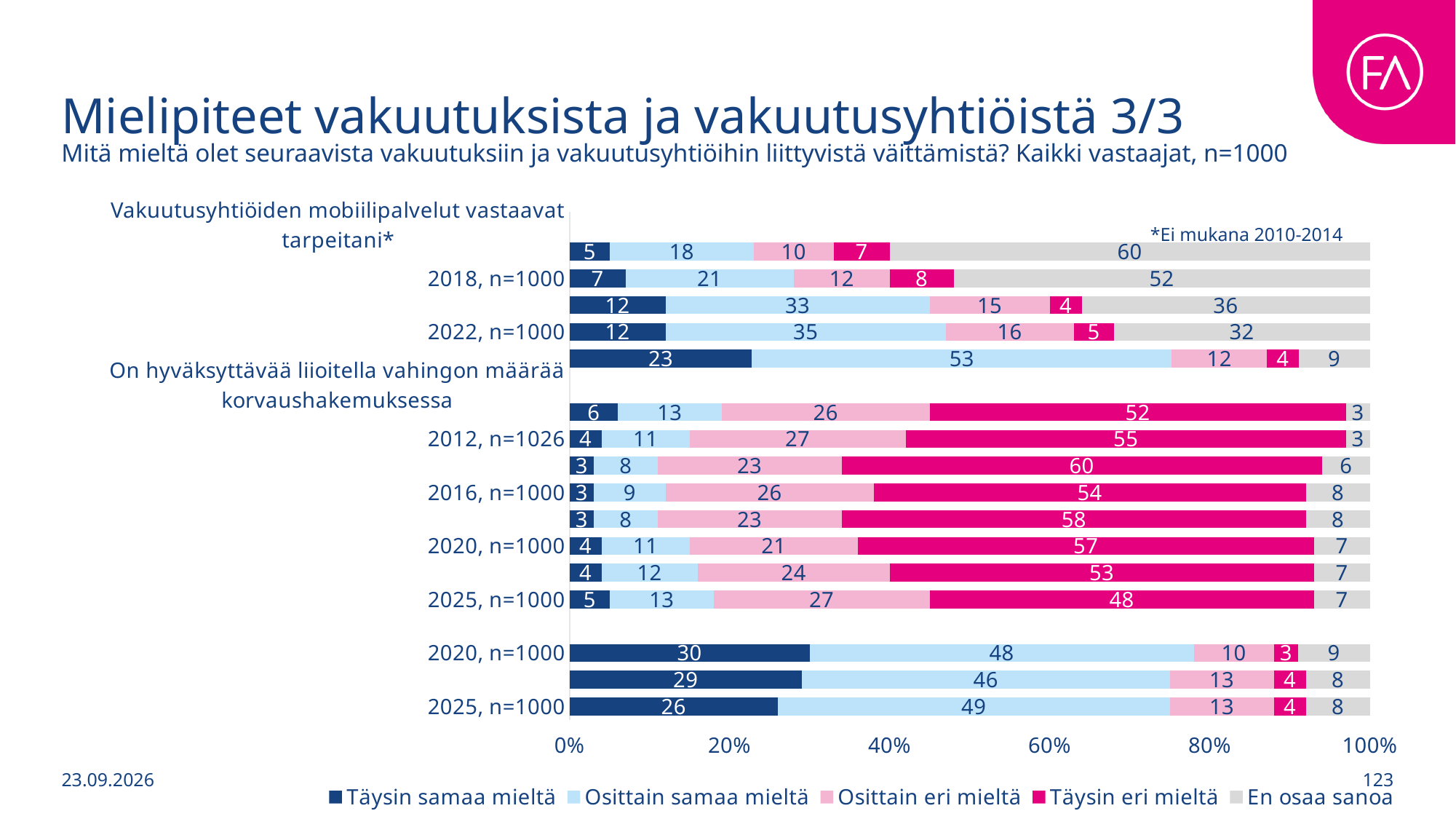
In the last (bottom) row of the chart, labelled "2025, n=1000", which is larger: "Osittain samaa mieltä" or "Täysin samaa mieltä"? Osittain samaa mieltä In the row labelled "2016, n=1000", what is the value for "En osaa sanoa"? 8 What is the first entry in the chart's legend? Täysin samaa mieltä In the row labelled "2022, n=1000", what is the value for "Osittain samaa mieltä"? 35 In the row labelled "2012, n=1026", what is the value for "Täysin eri mieltä"? 55 What is the total of the segments in the last (bottom) row of the chart, labelled "2025, n=1000"? 100 How many series does the legend of the chart list? 5 In the row labelled "2012, n=1026", which series has the largest value? Täysin eri mieltä In the last (bottom) row of the chart, labelled "2025, n=1000", what is the value for "Täysin samaa mieltä"? 26 In the row labelled "2018, n=1000", what is the value for "En osaa sanoa"? 52 What kind of chart is shown on the slide? Stacked bar chart In the row labelled "2016, n=1000", what is the difference between the "Täysin eri mieltä" value and the "Osittain eri mieltä" value? 28